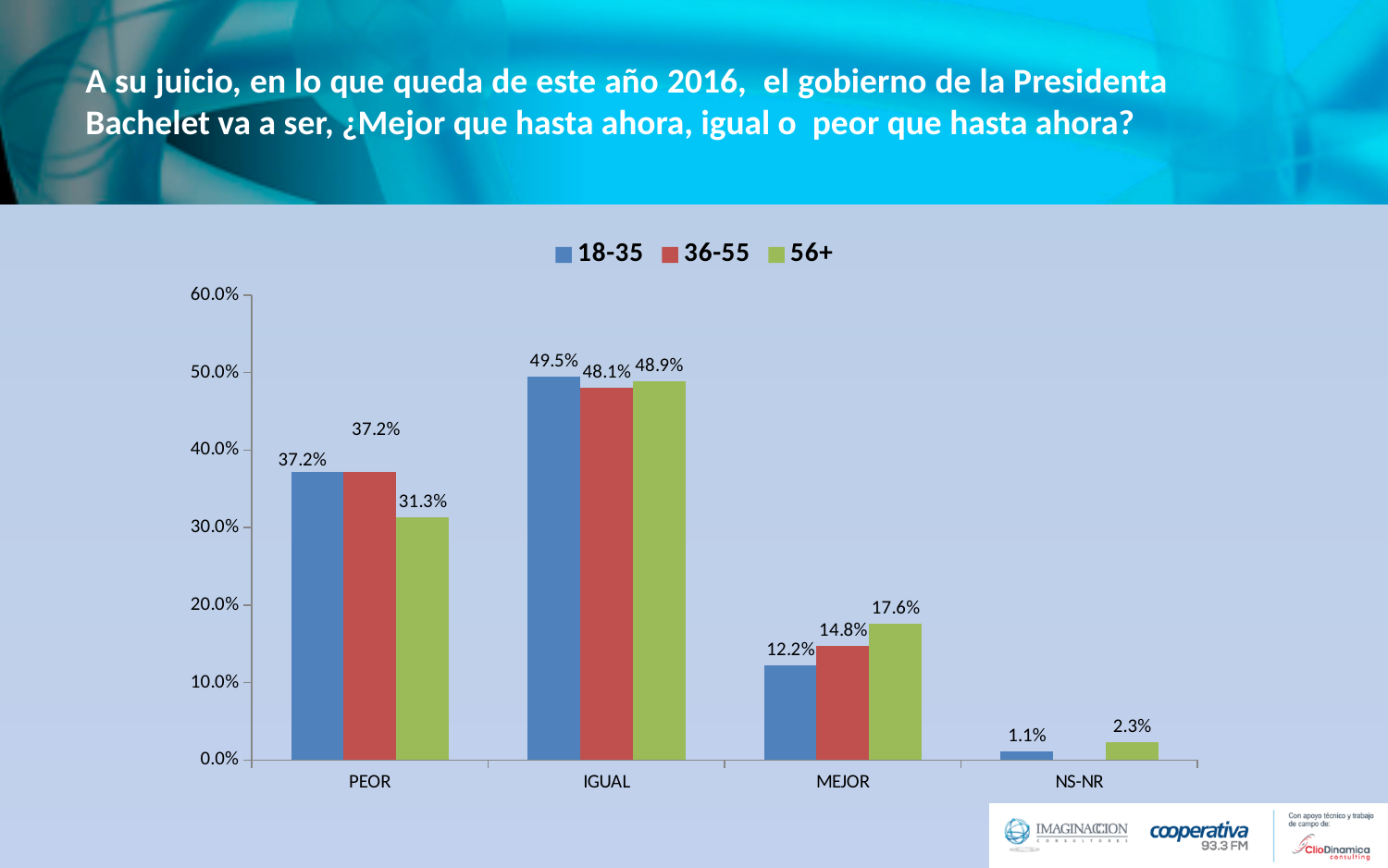
What is the value for the 36-55 group in the MEJOR category? 14.8% What is the value for the 56+ group in the PEOR category? 31.3% How many series does the legend list? 3 What is the difference between the 56+ and 18-35 values in the MEJOR category? 5.4% How many categories are shown on the x axis? 4 What kind of chart is shown on the slide? bar chart What is the value for the 18-35 group in the IGUAL category? 49.5% Which category has the highest value for the 56+ group? IGUAL Which legend entry is shown in green? 56+ In the PEOR category, which is larger: the value for 18-35 or the value for 56+? 18-35 What is the value for the 56+ group in the NS-NR category? 2.3% Which category has the lowest value for the 18-35 group? NS-NR